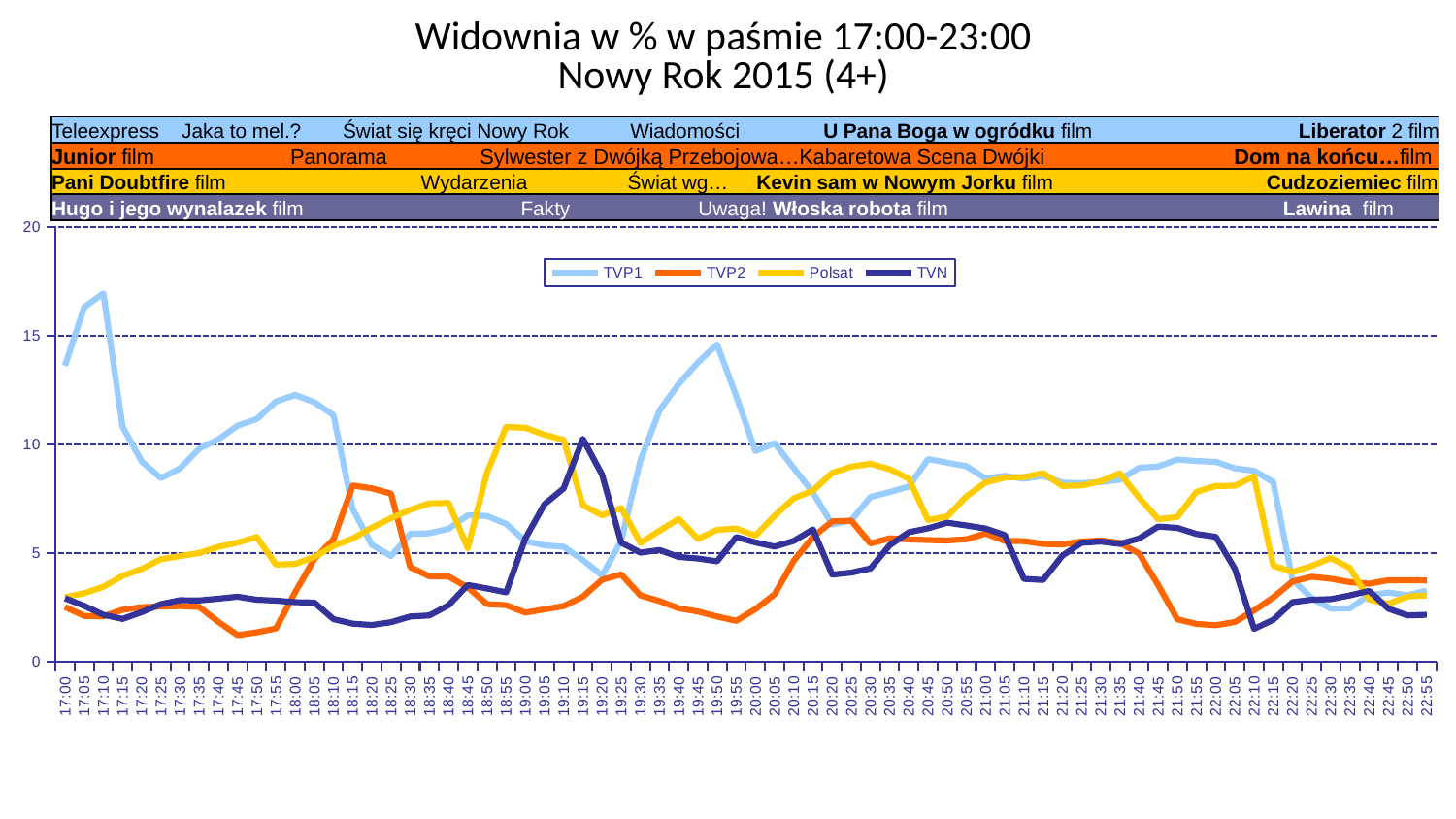
Is the value for TVP1 at 17:10 greater or less than 15? greater At 18:55, which series has the higher value, Polsat or TVP1? Polsat Which series has the lowest value at 17:45? TVP2 Does the TVP1 line rise or fall between 17:10 and 17:25? fall Is the value for TVN at 22:10 greater or less than 5? less Which series reaches the highest value anywhere on the chart? TVP1 What is the title of the chart? Widownia w % w paśmie 17:00-23:00 Nowy Rok 2015 (4+) What kind of chart is shown on the slide? line chart How many series does the legend list? 4 Is the value for Polsat at 18:55 greater or less than 10? greater Which colour is used for the Polsat series in the legend? yellow